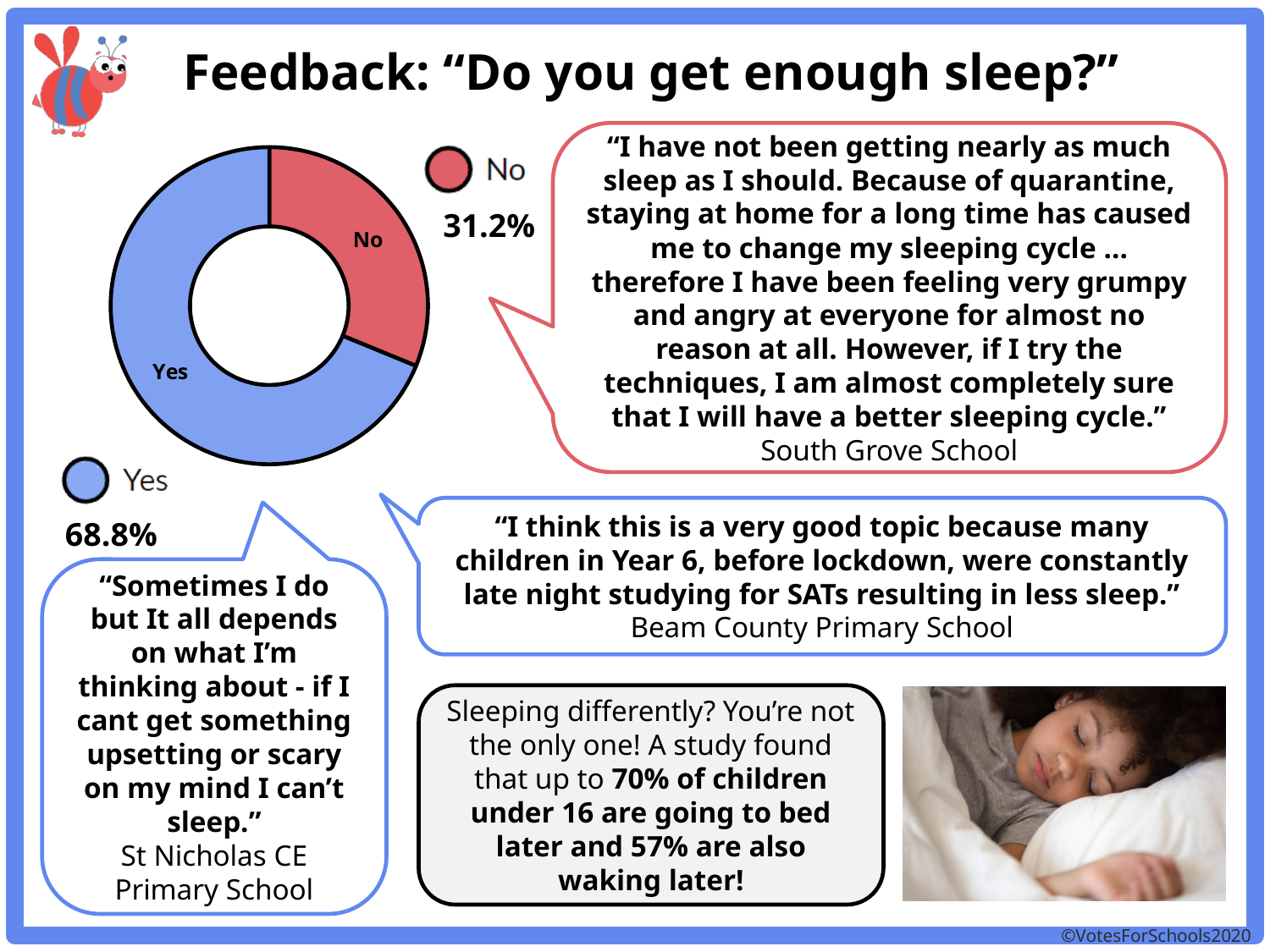
What kind of chart is shown on the slide? Pie chart (doughnut) What percentage of respondents answered "Yes" to "Do you get enough sleep?"? 68.8% Which response has the larger share of the chart, Yes or No? Yes What colour represents the "No" response in the chart? Red Is the share for "No" greater or less than 50%? less What is the difference in percentage points between the Yes and No shares? 37.6 How many categories does the chart show? 2 Which response has the smaller share of the chart? No Do the Yes and No shares add up to 100%? Yes What colour represents the "Yes" response in the chart? Blue What percentage of respondents answered "No" to "Do you get enough sleep?"? 31.2%